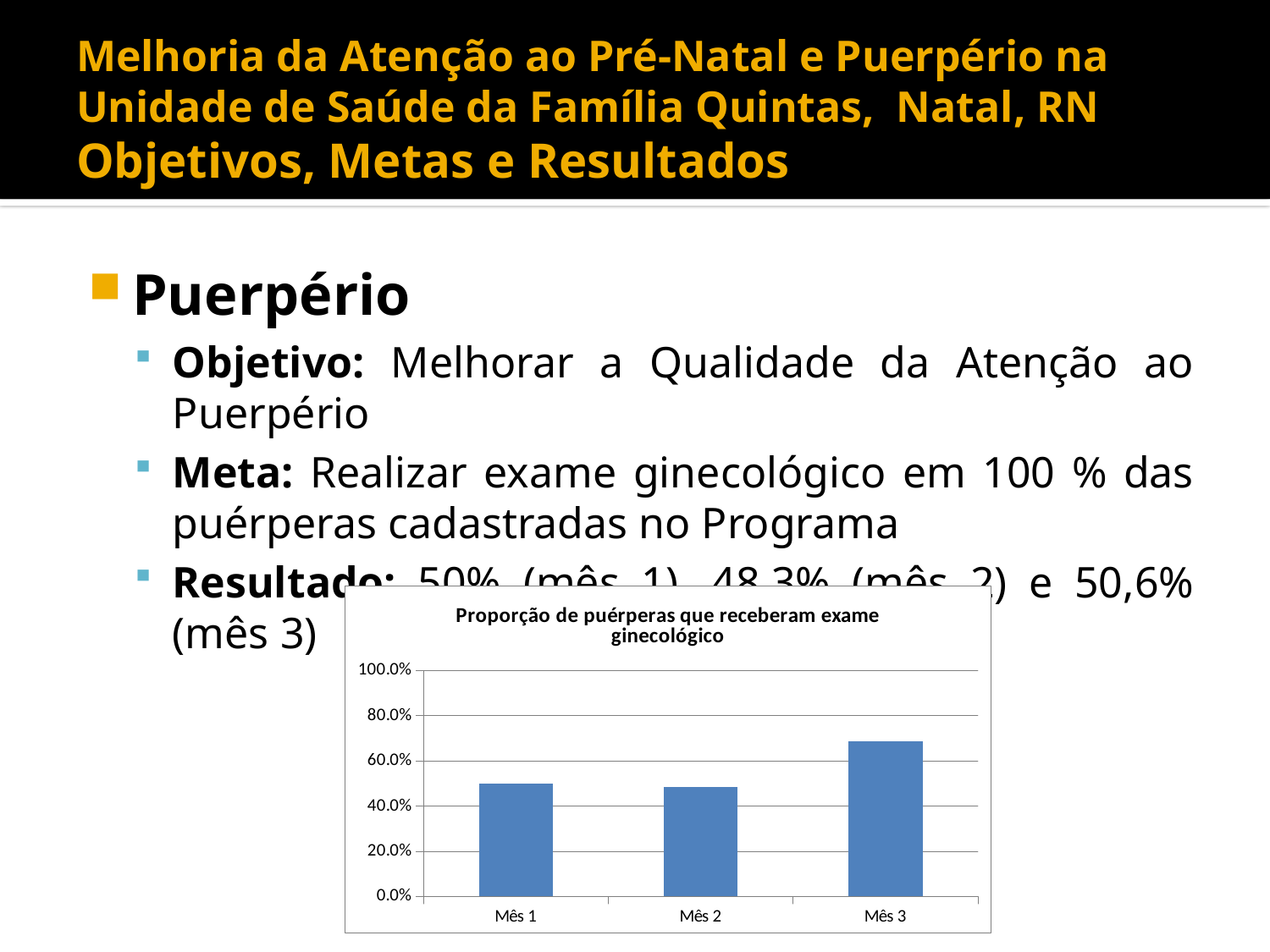
What is the title of the chart on the slide? Proporção de puérperas que receberam exame ginecológico Is the value for Mês 3 greater or less than 80.0%? less How many months (categories) are plotted in the chart? 3 Is the value for Mês 1 greater or less than 40.0%? greater Which is larger in the chart, the value for Mês 1 or the value for Mês 3? Mês 3 Does the value rise or fall from Mês 2 to Mês 3? rise Which month has the highest bar in the chart? Mês 3 What kind of chart is shown on the slide? bar chart Is the value for Mês 3 greater or less than 60.0%? greater What is the highest value shown on the vertical axis of the chart? 100.0%